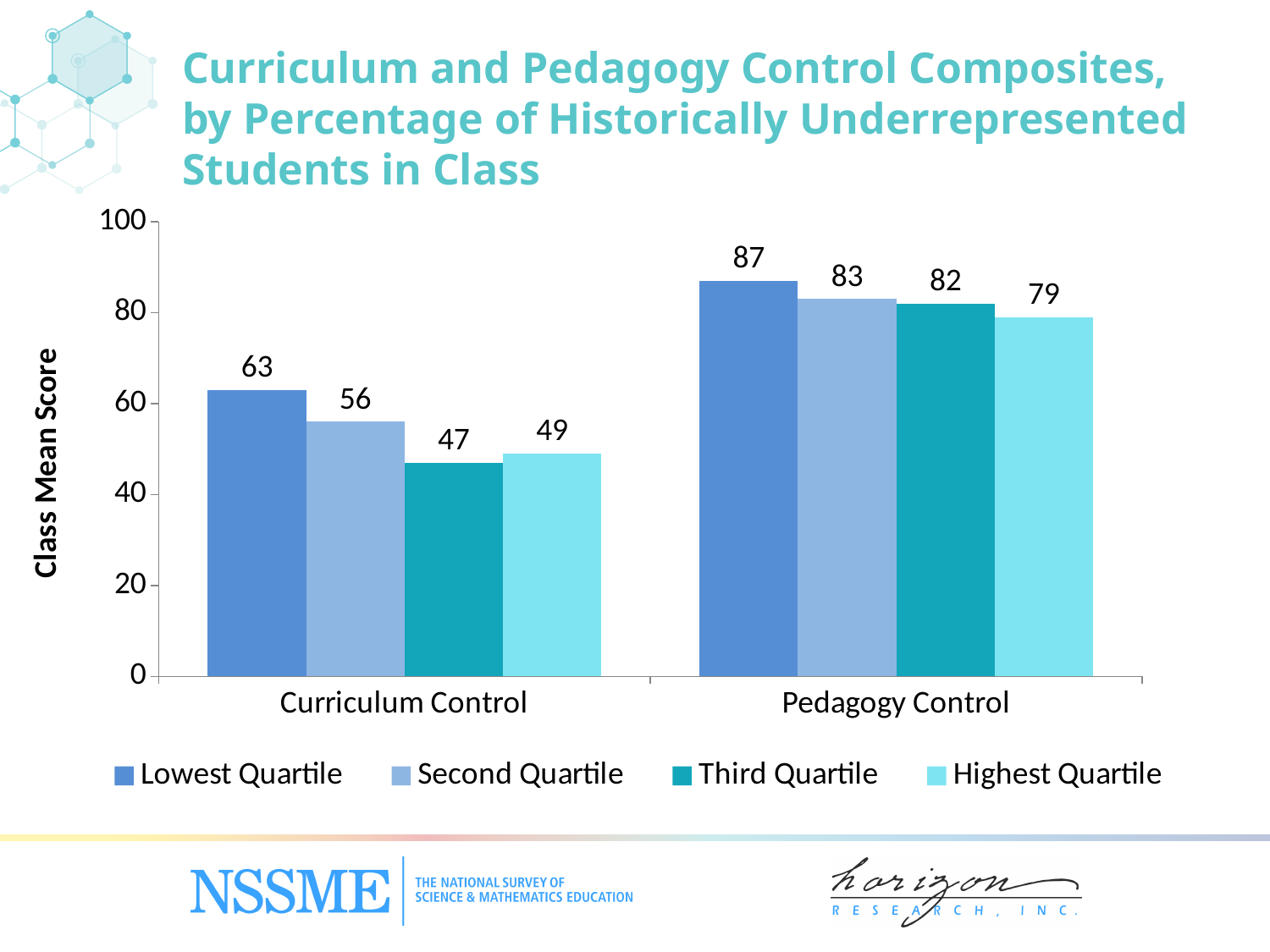
Which quartile has the lowest Class Mean Score for Curriculum Control? Third Quartile What is the Class Mean Score for the Third Quartile in Curriculum Control? 47 Which is larger for Curriculum Control: the Third Quartile score or the Highest Quartile score? Highest Quartile What is the Class Mean Score for the Highest Quartile in Pedagogy Control? 79 What is the label of the vertical axis? Class Mean Score What is the Class Mean Score for the Lowest Quartile in Curriculum Control? 63 What is the difference between the Second Quartile scores for Pedagogy Control and Curriculum Control? 27 How many series does the legend list? 4 Which quartile has the highest Class Mean Score for Pedagogy Control? Lowest Quartile How many categories are shown on the x axis? 2 What kind of chart is shown on the slide? Bar chart What is the difference between the Lowest Quartile and Highest Quartile scores for Curriculum Control? 14